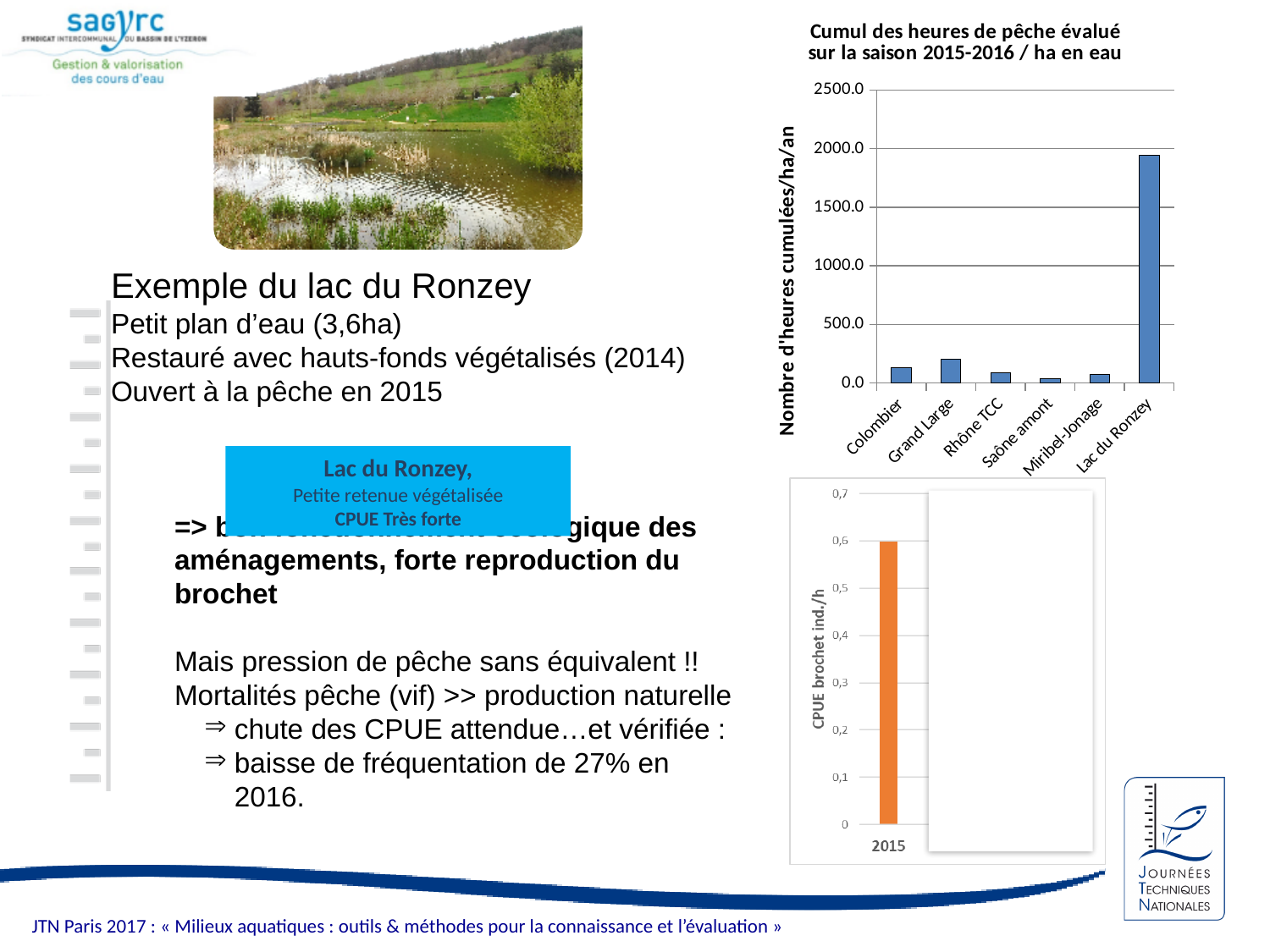
In the chart at the bottom right of the slide with the vertical axis "CPUE brochet ind./h", is the value for 2015 greater or less than 0,5? greater In the chart at the bottom right of the slide with the vertical axis "CPUE brochet ind./h", how many bars are plotted? 1 What kind of chart is the chart titled "Cumul des heures de pêche évalué sur la saison 2015-2016 / ha en eau"? bar chart What kind of chart is the chart at the bottom right of the slide with the vertical axis "CPUE brochet ind./h"? bar chart In the chart titled "Cumul des heures de pêche évalué sur la saison 2015-2016 / ha en eau", what is the label of the vertical axis? Nombre d'heures cumulées/ha/an In the chart titled "Cumul des heures de pêche évalué sur la saison 2015-2016 / ha en eau", which is larger, the value for Grand Large or the value for Colombier? Grand Large In the chart titled "Cumul des heures de pêche évalué sur la saison 2015-2016 / ha en eau", how many categories are shown on the x axis? 6 In the chart titled "Cumul des heures de pêche évalué sur la saison 2015-2016 / ha en eau", is the value for Colombier greater or less than 500.0? less In the chart titled "Cumul des heures de pêche évalué sur la saison 2015-2016 / ha en eau", which category has the lowest value? Saône amont In the chart titled "Cumul des heures de pêche évalué sur la saison 2015-2016 / ha en eau", which category has the highest value? Lac du Ronzey In the chart titled "Cumul des heures de pêche évalué sur la saison 2015-2016 / ha en eau", which is larger, the value for Lac du Ronzey or the value for Miribel-Jonage? Lac du Ronzey In the chart titled "Cumul des heures de pêche évalué sur la saison 2015-2016 / ha en eau", is the value for Lac du Ronzey greater or less than 1500.0? greater